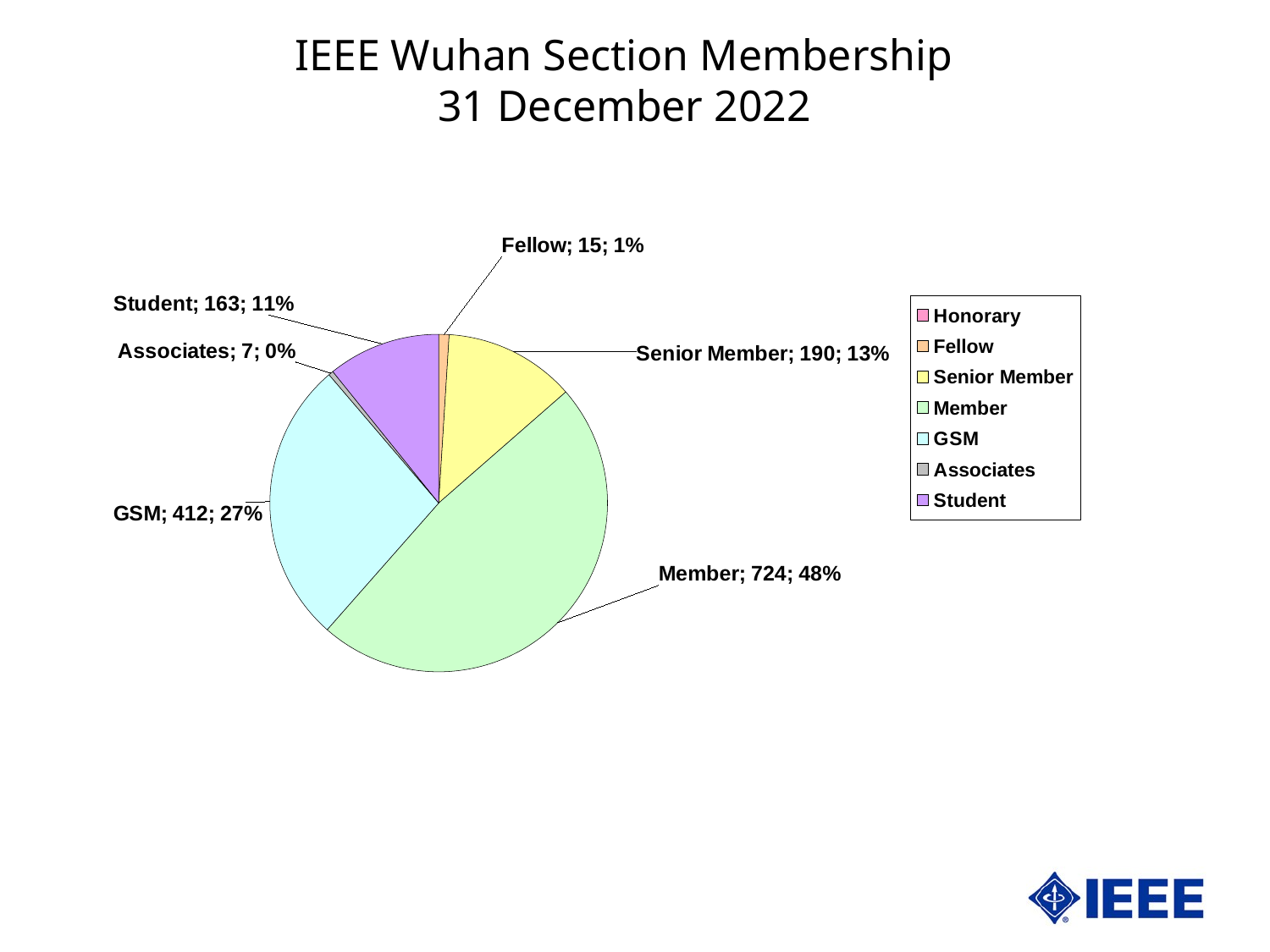
Which labelled category has the smallest count? Associates What kind of chart is shown on the slide? Pie chart What is the difference between the Member count and the GSM count? 312 Which is larger, the Senior Member count or the Student count? Senior Member How many Fellows are shown? 15 What percentage of the membership is GSM? 27% How many categories does the legend list? 7 How many members are in the Member category? 724 What is the title of the chart? IEEE Wuhan Section Membership 31 December 2022 How many Senior Members are shown? 190 What share of the membership is Student? 11% Which category has the largest slice of the pie? Member